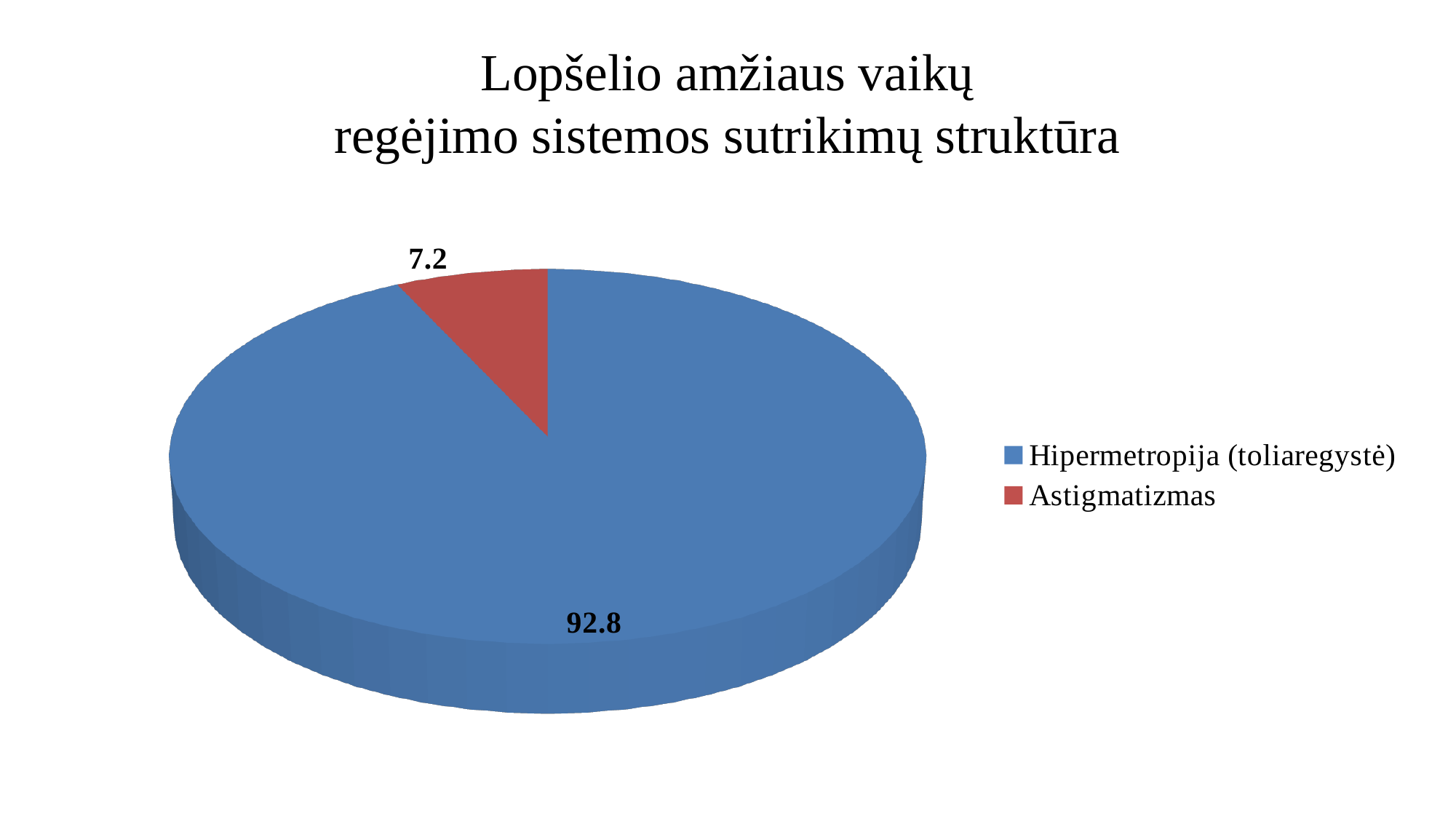
What kind of chart is shown on the slide? Pie chart What value is shown for Hipermetropija (toliaregystė)? 92.8 What is the difference between the values for Hipermetropija (toliaregystė) and Astigmatizmas? 85.6 What is the total of the two values shown on the pie chart? 100 What is the title of the chart? Lopšelio amžiaus vaikų regėjimo sistemos sutrikimų struktūra How many entries does the legend list? 2 Which category has the largest slice of the pie? Hipermetropija (toliaregystė) What colour is the slice for Astigmatizmas? Red How many categories does the pie chart show? 2 What value is shown for Astigmatizmas? 7.2 Which is larger, the value for Hipermetropija (toliaregystė) or for Astigmatizmas? Hipermetropija (toliaregystė) Which category has the smallest slice of the pie? Astigmatizmas